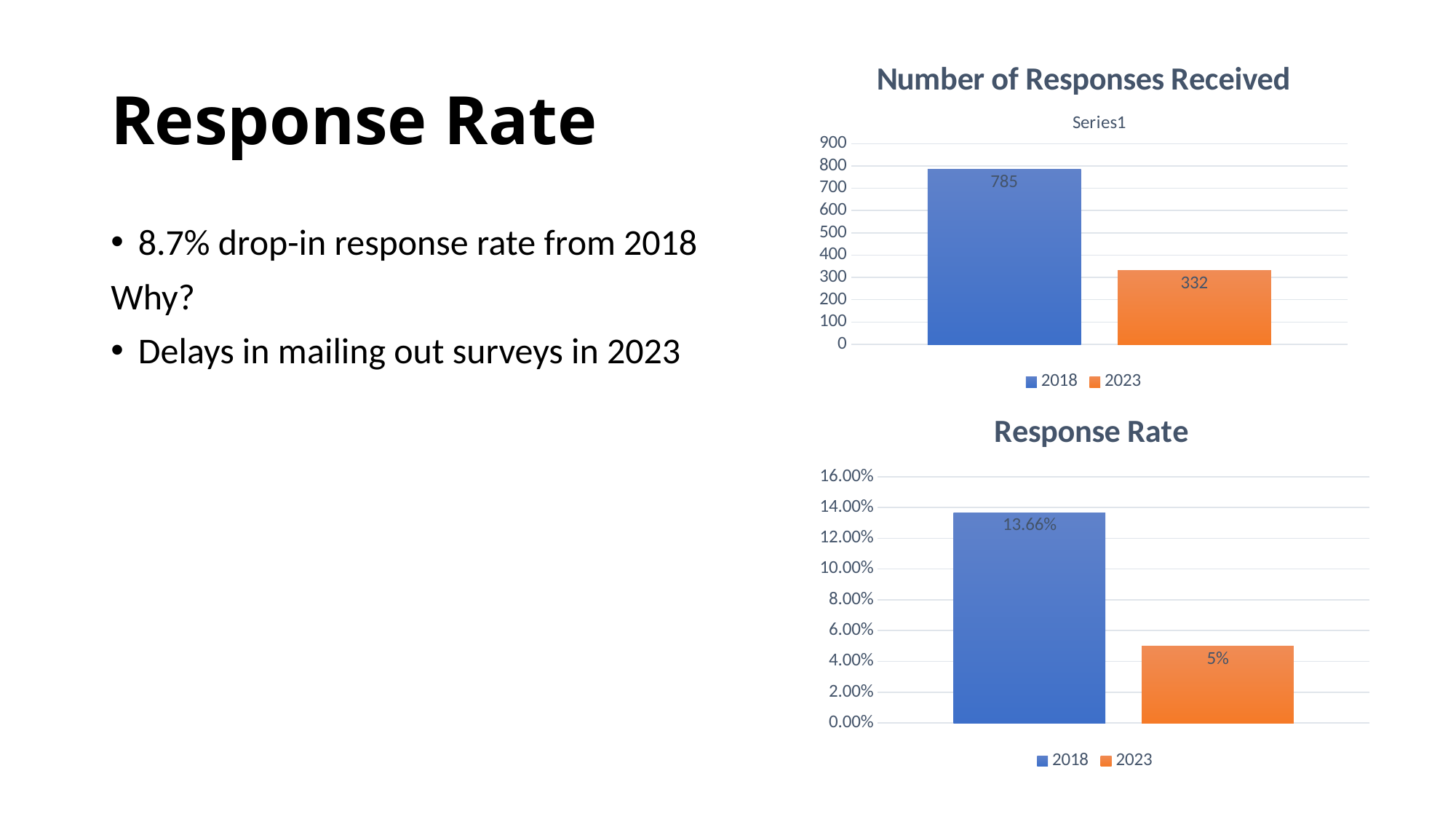
In the 'Number of Responses Received' chart, which year has the higher number of responses? 2018 In the 'Number of Responses Received' chart, what is the value for 2023? 332 In the 'Number of Responses Received' chart, what is the difference between the 2018 and 2023 values? 453 In the 'Response Rate' chart, what is the value for 2018? 13.66% What kind of chart is the 'Number of Responses Received' chart? Bar chart In the 'Response Rate' chart, which year has the lower response rate? 2023 In the 'Response Rate' chart, how many bars are plotted? 2 In the 'Number of Responses Received' chart, is the value for 2023 greater or less than 400? less In the 'Response Rate' chart, which colour is used for the 2023 bar? Orange In the 'Response Rate' chart, what is the value for 2023? 5% In the 'Response Rate' chart, is the value for 2018 greater or less than 12.00%? greater In the 'Number of Responses Received' chart, what is the value for 2018? 785